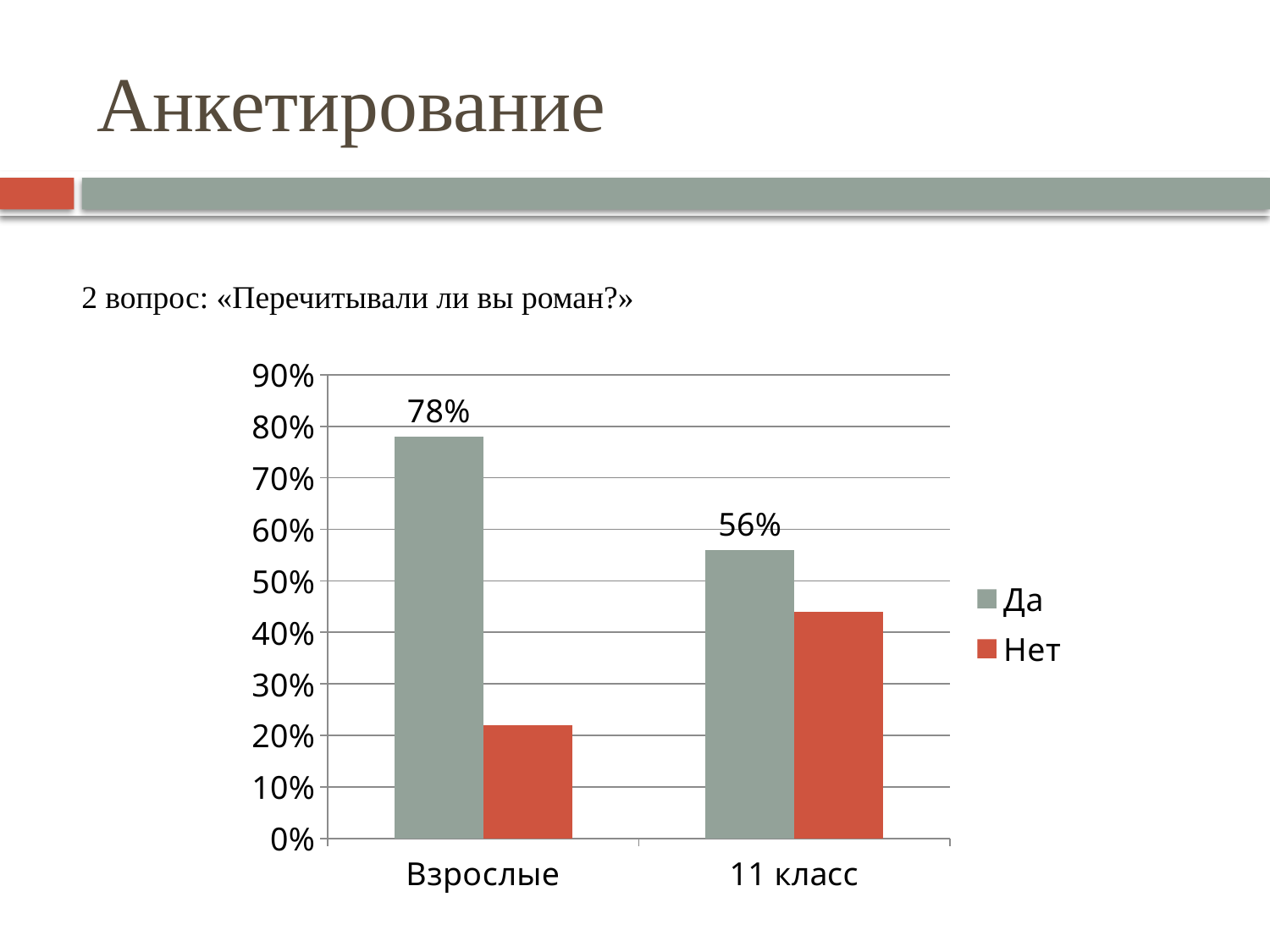
Is the "Нет" value for "11 класс" greater or less than 40%? greater How many categories are shown on the x axis? 2 What are the two entries in the chart legend? Да, Нет What is the difference between the "Да" values for "Взрослые" and "11 класс"? 22% How many series does the legend list? 2 Which category has the higher value for "Да"? Взрослые Which category has the lower value for "Да"? 11 класс Which is larger for "11 класс": the "Да" value or the "Нет" value? Да Is the "Нет" value for "Взрослые" greater or less than 30%? less What is the value of "Да" for "Взрослые"? 78% What kind of chart is shown on the slide? bar chart What is the value of "Да" for "11 класс"? 56%